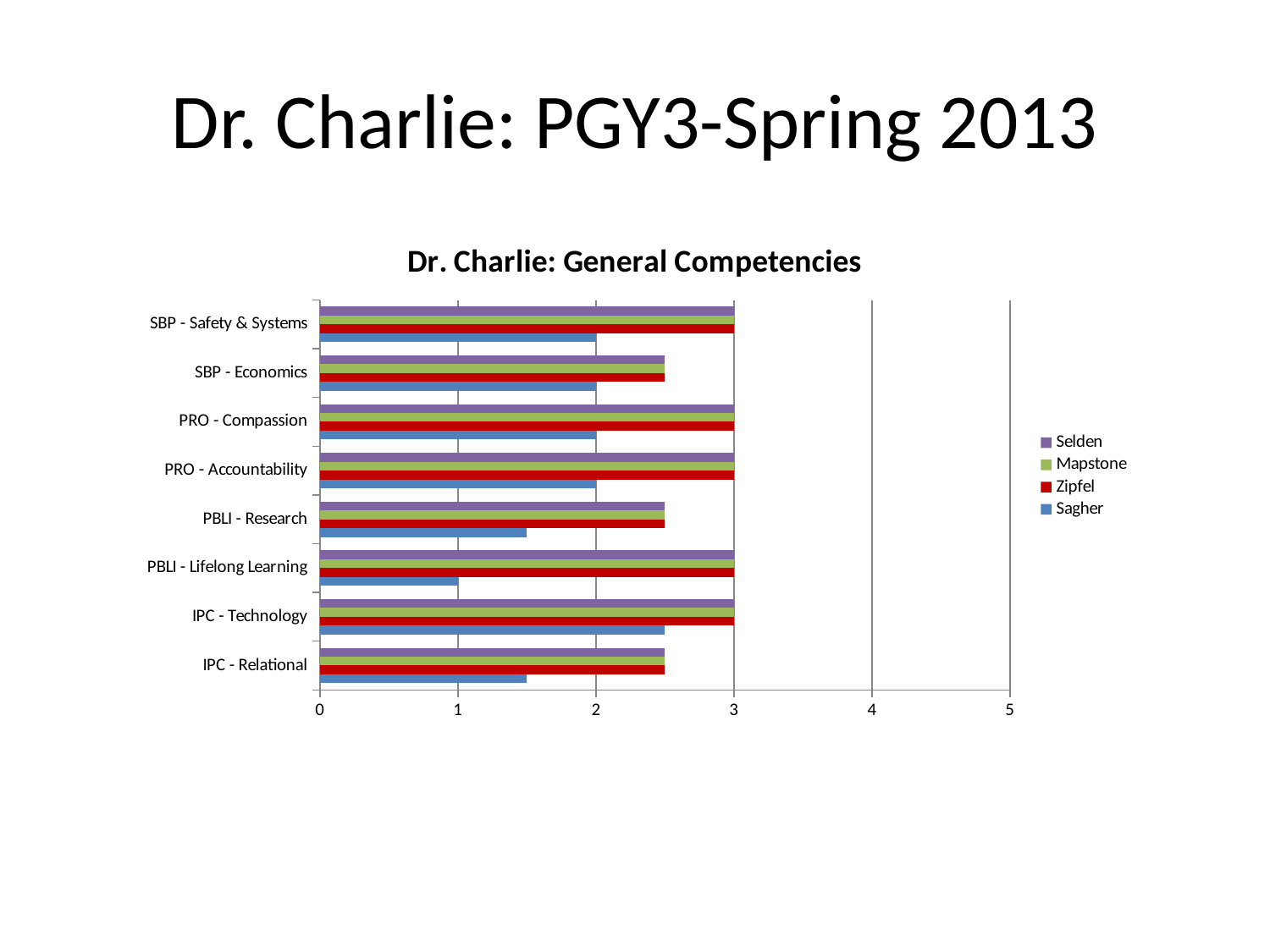
What is the Sagher value for PBLI - Lifelong Learning? 1 How many competency categories are shown on the chart? 8 Which is larger for IPC - Relational, the Mapstone value or the Sagher value? Mapstone How many series does the legend list? 4 Is the Sagher value for PBLI - Research greater or less than 2? less What is the Zipfel value for PRO - Compassion? 3 Which series has the lowest value for PBLI - Lifelong Learning? Sagher What is the Selden value for IPC - Technology? 3 What is the title of the chart? Dr. Charlie: General Competencies Is the Zipfel value for SBP - Economics greater or less than 2? greater What kind of chart is shown on the slide? bar chart What is the Sagher value for SBP - Safety & Systems? 2